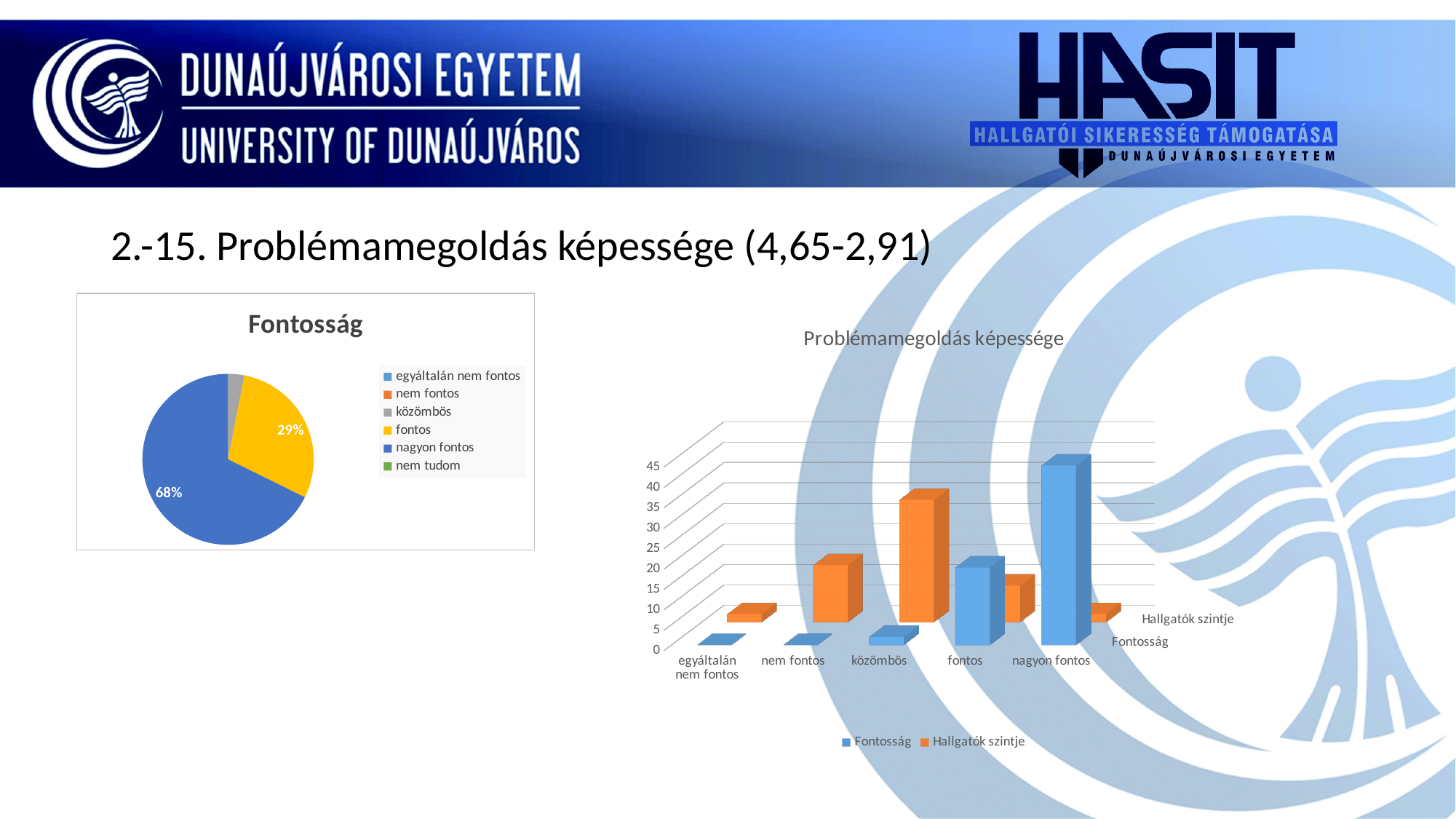
In the pie chart titled Fontosság, what is the difference in percentage points between the nagyon fontos slice and the fontos slice? 39 percentage points In the pie chart titled Fontosság, how many entries does the legend list? 6 In the chart titled Problémamegoldás képessége, how many series does the legend list? 2 In the pie chart titled Fontosság, what percentage is shown for the fontos slice? 29% In the pie chart titled Fontosság, what percentage is shown for the nagyon fontos slice? 68% In the chart titled Problémamegoldás képessége, which category has the highest Fontosság value? nagyon fontos In the chart titled Problémamegoldás képessége, how many categories are shown on the x axis? 5 In the pie chart titled Fontosság, which category has the largest slice? nagyon fontos In the chart titled Problémamegoldás képessége, which category has the highest Hallgatók szintje value? közömbös What kind of chart is the chart on the left of the slide? Pie chart What kind of chart is the chart titled Problémamegoldás képessége? Bar chart